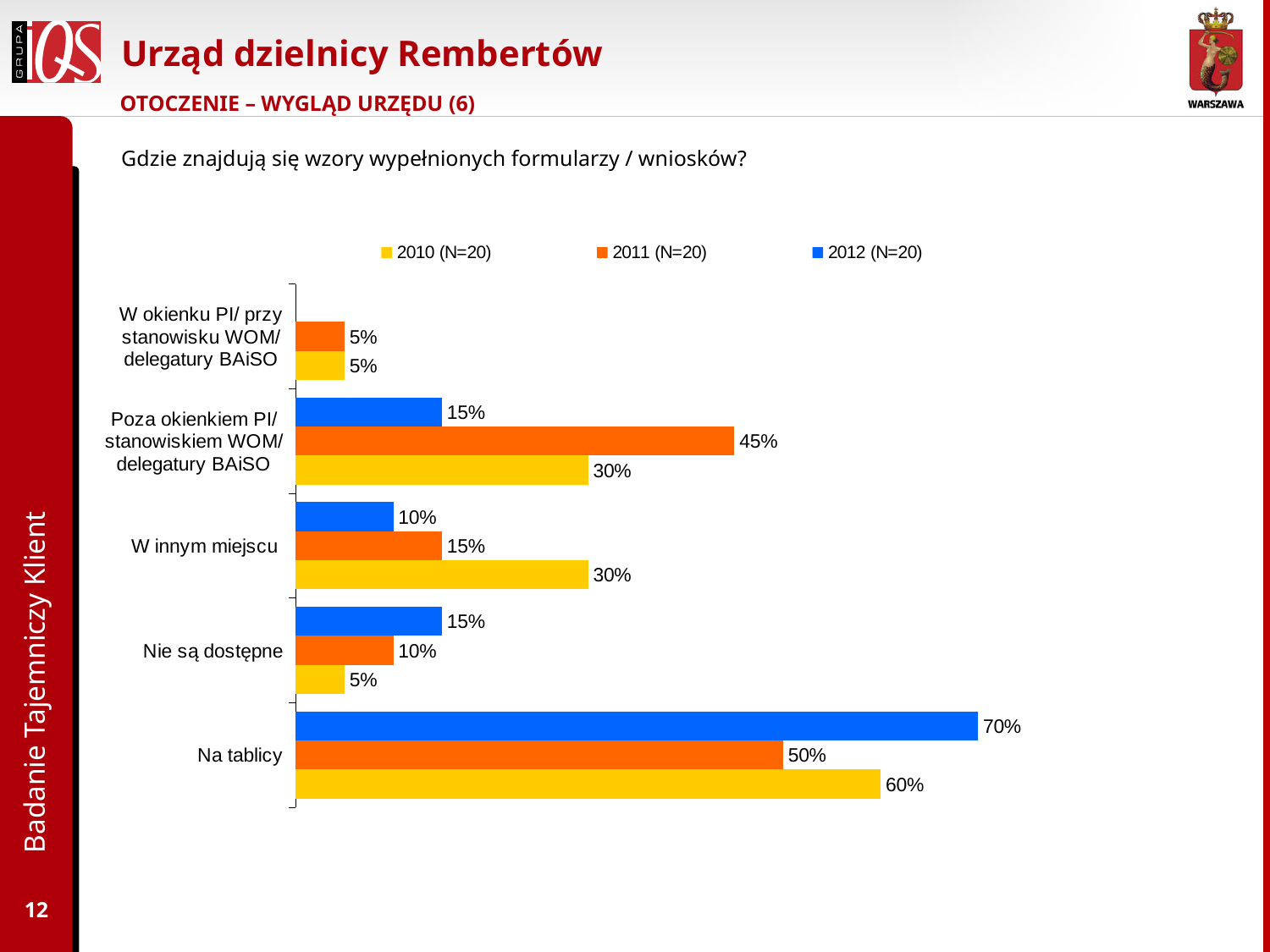
What is the value for 'Na tablicy' in the 2012 (N=20) series? 70% How many series does the legend list? 3 What is the value for 'W innym miejscu' in the 2010 (N=20) series? 30% What kind of chart is shown on the slide? Bar chart Which category has the lowest value in the 2010 (N=20) series? W okienku PI/ przy stanowisku WOM/ delegatury BAiSO and Nie są dostępne (both 5%) For 'W innym miejscu', which series has the larger value: 2010 (N=20) or 2012 (N=20)? 2010 (N=20) What is the value for 'Nie są dostępne' in the 2012 (N=20) series? 15% How many categories are shown on the chart? 5 What is the difference between the 2012 and 2011 values for 'Na tablicy'? 20% Which colour represents the 2011 (N=20) series in the legend? Orange What is the value for 'Poza okienkiem PI/ stanowiskiem WOM/ delegatury BAiSO' in the 2011 (N=20) series? 45% Which category has the highest value in the 2012 (N=20) series? Na tablicy